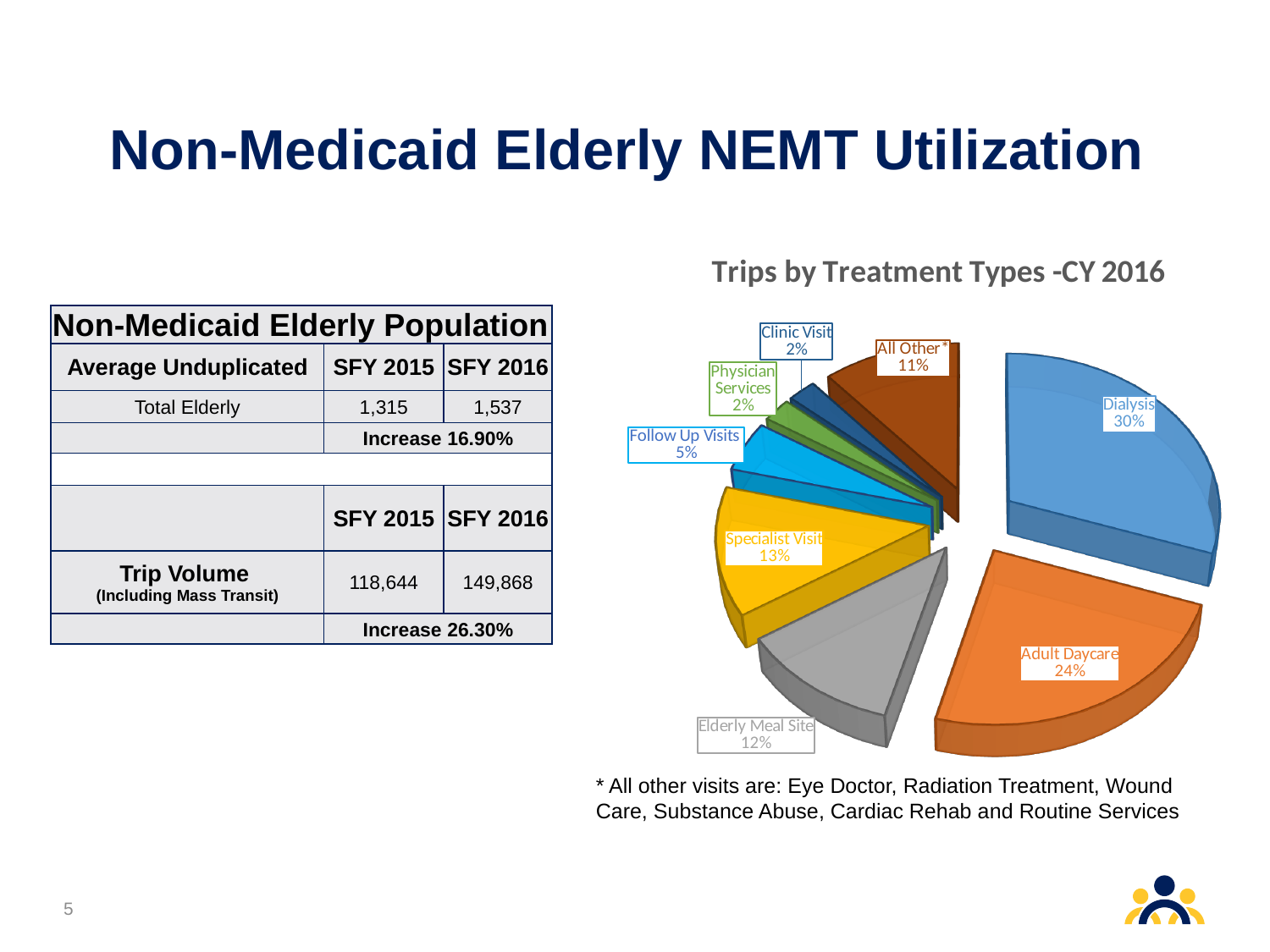
What percentage of trips is for All Other? 11% What is the title of the chart? Trips by Treatment Types -CY 2016 What share of trips is for Dialysis? 30% Which treatment type has the largest share of trips? Dialysis How many slices does the pie chart have? 8 What percentage of trips is for Follow Up Visits? 5% What percentage of trips is for Elderly Meal Site? 12% What share of trips is for Adult Daycare? 24% Which has a larger share of trips, Specialist Visit or Elderly Meal Site? Specialist Visit What type of chart is shown on the slide? pie chart What is the difference in percentage points between Dialysis and Adult Daycare? 6 What percentage of trips is for Specialist Visit? 13%